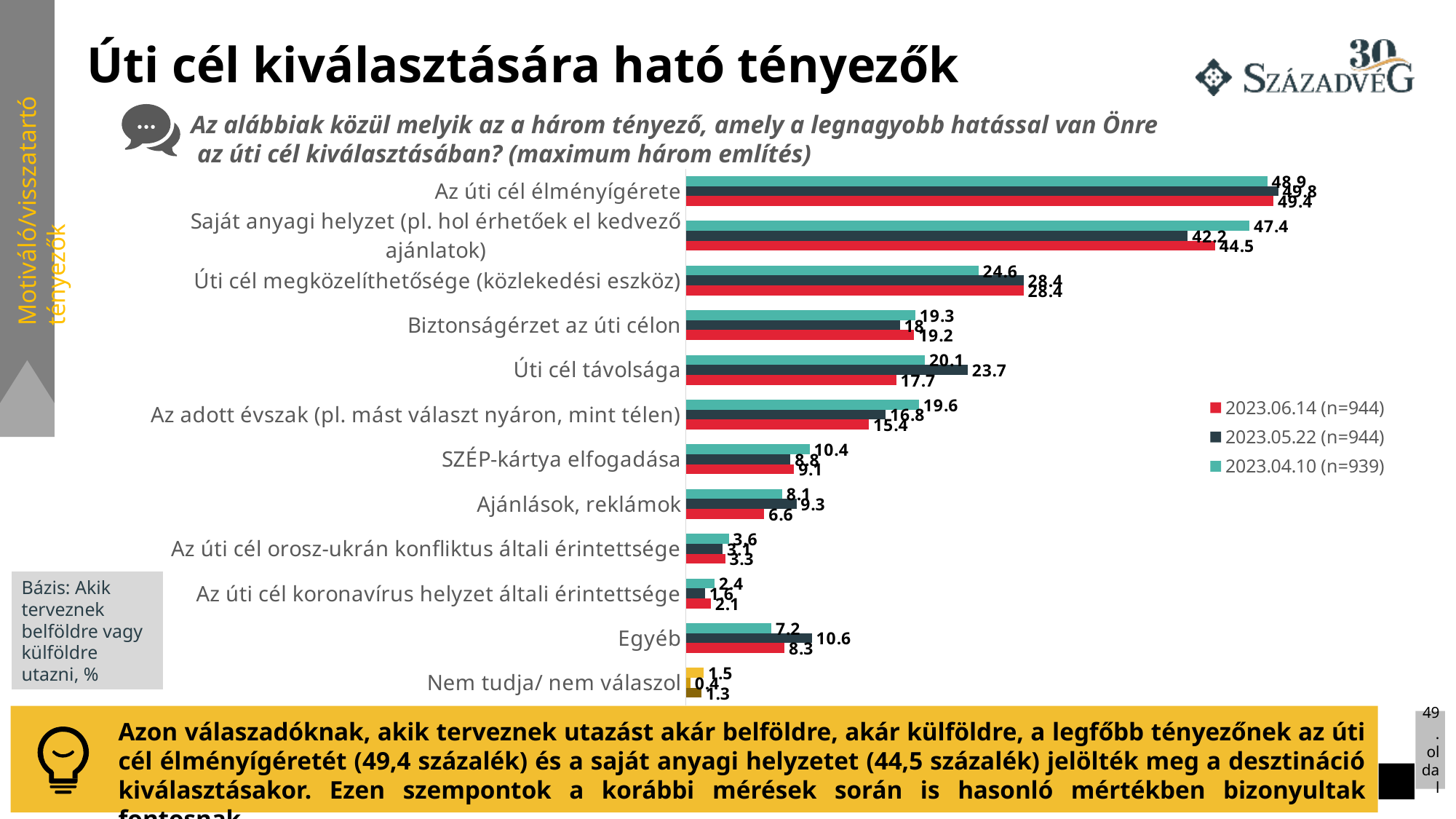
What is the 2023.05.22 value for "Úti cél távolsága"? 23.7 For "Saját anyagi helyzet", what is the difference between the 2023.04.10 value and the 2023.05.22 value? 5.2 What is the 2023.04.10 value for "Az úti cél élményígérete"? 48.9 What is the 2023.05.22 value for "Egyéb"? 10.6 What kind of chart is shown on the slide? Bar chart Which category has the highest value in the 2023.06.14 series? Az úti cél élményígérete For "Úti cél távolsága", which series has the larger value: 2023.05.22 or 2023.06.14? 2023.05.22 For "Ajánlások, reklámok", what is the difference between the 2023.05.22 value and the 2023.06.14 value? 2.7 Which category has the lowest value in the 2023.04.10 series? Nem tudja/ nem válaszol How many categories are shown on the chart? 12 What is the 2023.06.14 value for "Saját anyagi helyzet (pl. hol érhetőek el kedvező ajánlatok)"? 44.5 How many series does the legend list? 3